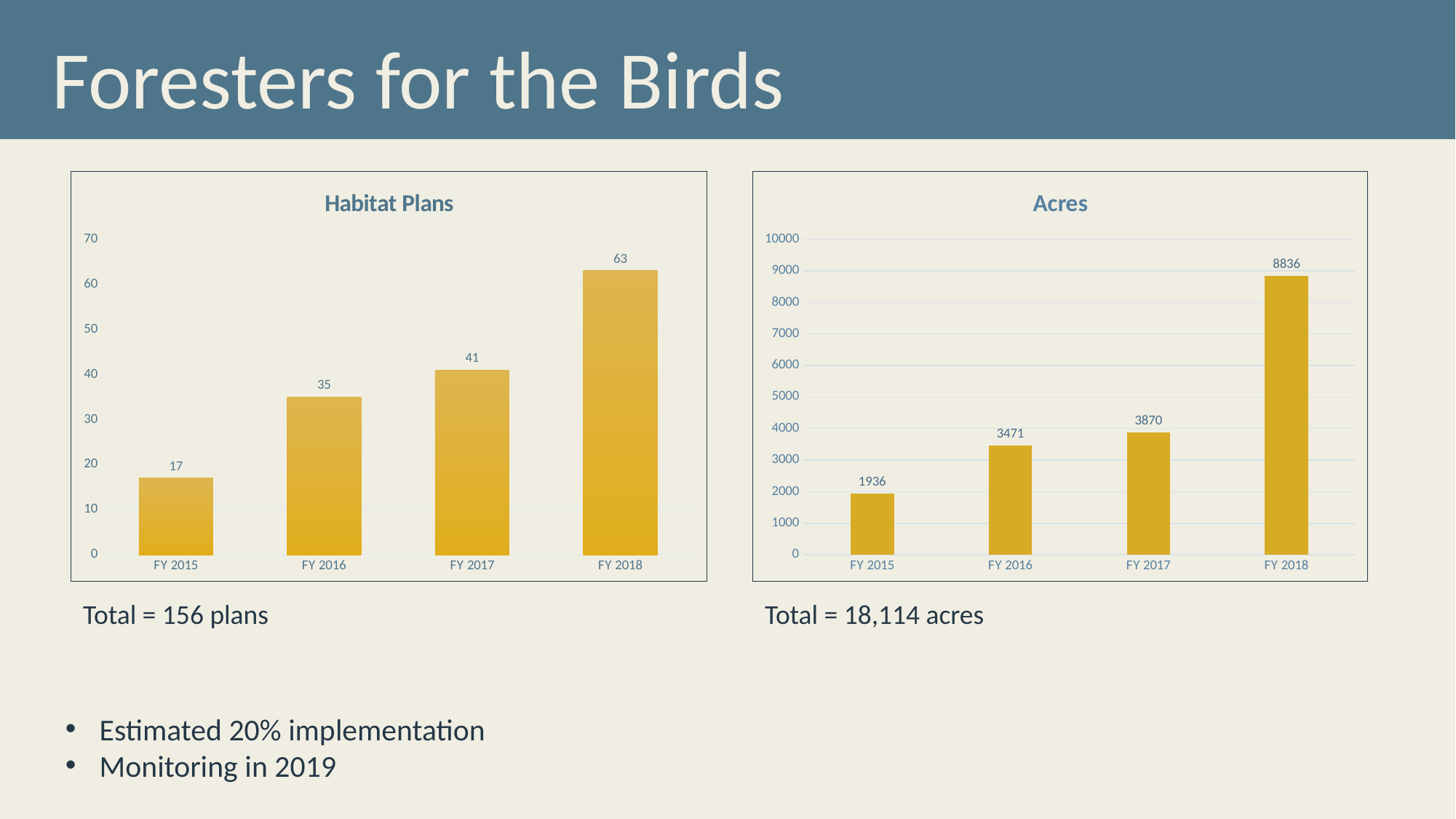
What kind of chart is the Acres chart? bar chart In the Habitat Plans chart, which fiscal year has the highest value? FY 2018 In the Habitat Plans chart, what is the value for FY 2017? 41 In the Acres chart, is the value for FY 2018 greater or less than 8000? greater In the Acres chart, what is the value for FY 2016? 3471 In the Acres chart, which is larger, the value for FY 2016 or FY 2017? FY 2017 How many bars are in the Habitat Plans chart? 4 What is the title of the chart on the right side of the slide? Acres In the Acres chart, which fiscal year has the lowest value? FY 2015 In the Acres chart, what is the difference between the FY 2018 and FY 2017 values? 4966 In the Habitat Plans chart, what is the difference between the FY 2018 and FY 2015 values? 46 In the Habitat Plans chart, do the values rise or fall from FY 2015 to FY 2018? rise